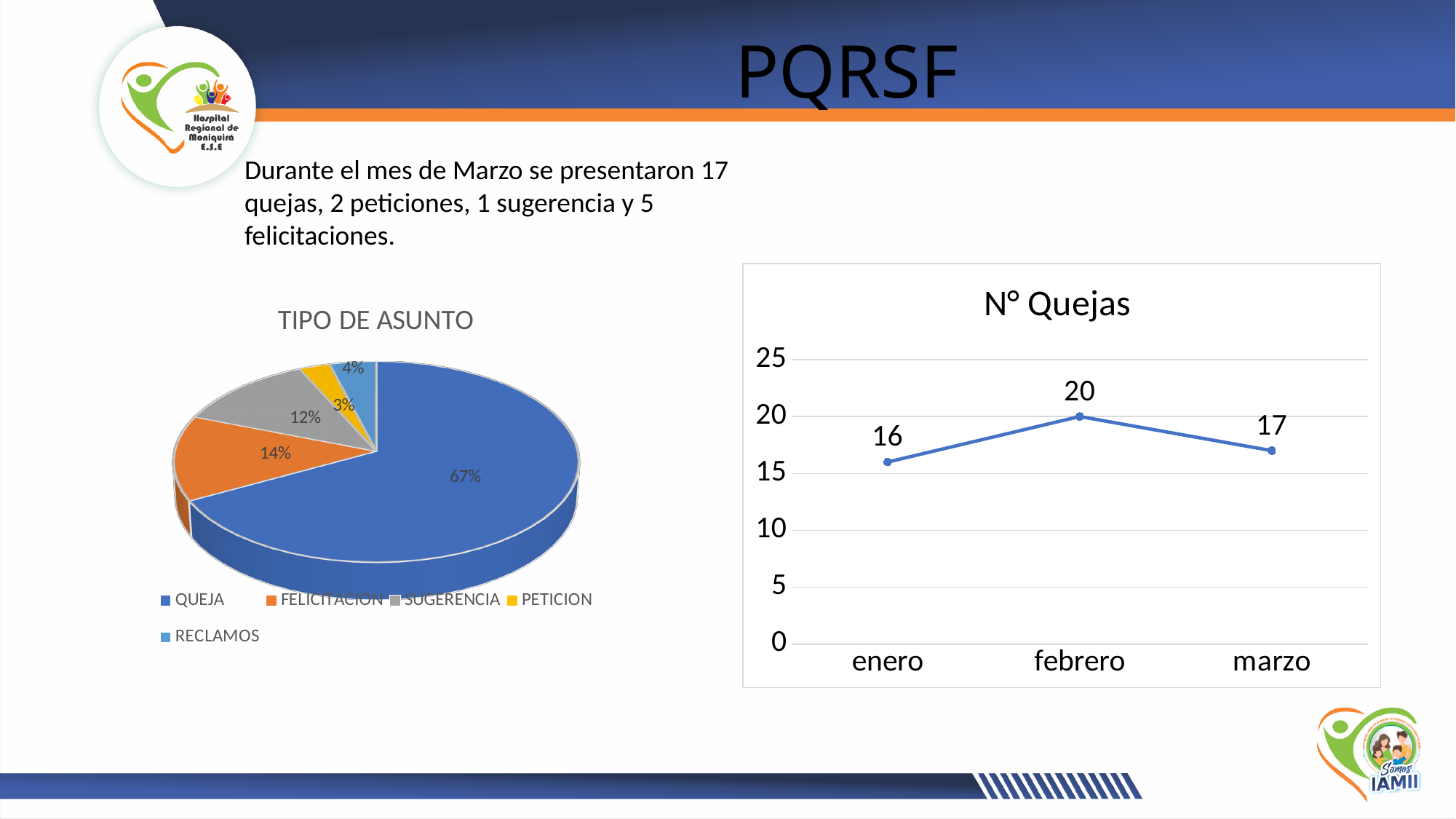
In the 'N° Quejas' chart, what is the value for febrero? 20 In the 'N° Quejas' chart, which month has the highest value? febrero What kind of chart is 'N° Quejas'? Line chart In the 'N° Quejas' chart, what is the difference between the values for febrero and marzo? 3 In the 'TIPO DE ASUNTO' chart, what share of the pie does QUEJA take? 67% In the 'TIPO DE ASUNTO' chart, what percentage is shown for SUGERENCIA? 12% In the 'TIPO DE ASUNTO' chart, which category has the largest slice? QUEJA What kind of chart is 'TIPO DE ASUNTO'? Pie chart In the 'TIPO DE ASUNTO' chart, what percentage is shown for FELICITACION? 14% In the 'N° Quejas' chart, which month has the lowest value? enero In the 'N° Quejas' chart, what is the value for enero? 16 In the 'TIPO DE ASUNTO' chart, how many categories does the legend list? 5